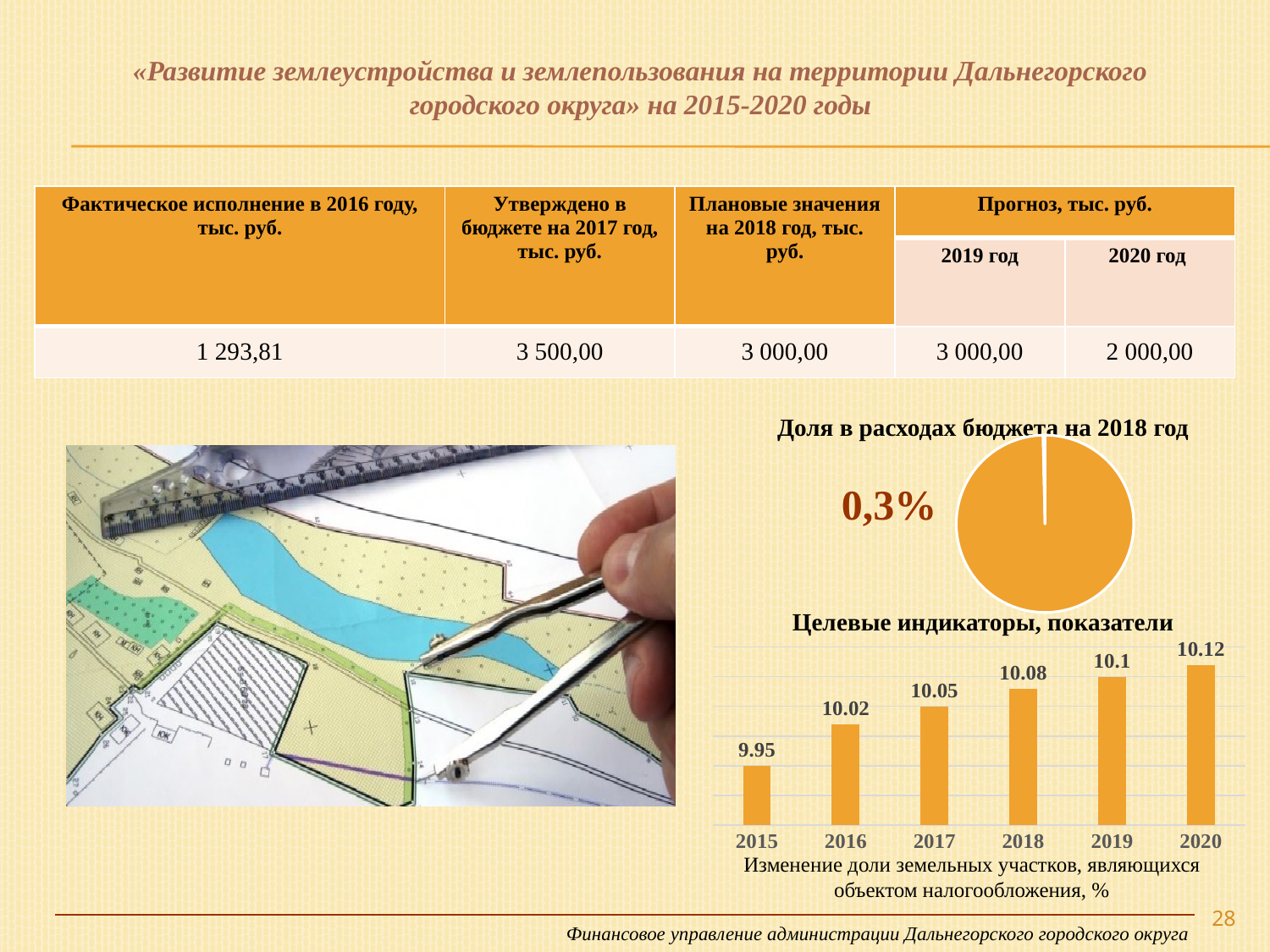
On the bar chart 'Целевые индикаторы, показатели', which year has the highest value? 2020 On the bar chart 'Целевые индикаторы, показатели', which year has the lowest value? 2015 On the bar chart 'Целевые индикаторы, показатели', which is larger, the value for 2017 or the value for 2019? 2019 On the pie chart 'Доля в расходах бюджета на 2018 год', what share is labelled on the slide? 0,3% On the bar chart 'Целевые индикаторы, показатели', what is the value for 2018? 10.08 On the bar chart 'Целевые индикаторы, показатели', what is the value for 2020? 10.12 On the bar chart 'Целевые индикаторы, показатели', do the values rise or fall from 2015 to 2020? rise What kind of chart is 'Доля в расходах бюджета на 2018 год'? pie chart On the bar chart 'Целевые индикаторы, показатели', what is the difference between the values for 2020 and 2015? 0.17 On the bar chart 'Целевые индикаторы, показатели', what is the value for 2015? 9.95 What kind of chart is 'Целевые индикаторы, показатели'? bar chart On the bar chart 'Целевые индикаторы, показатели', how many years are shown? 6